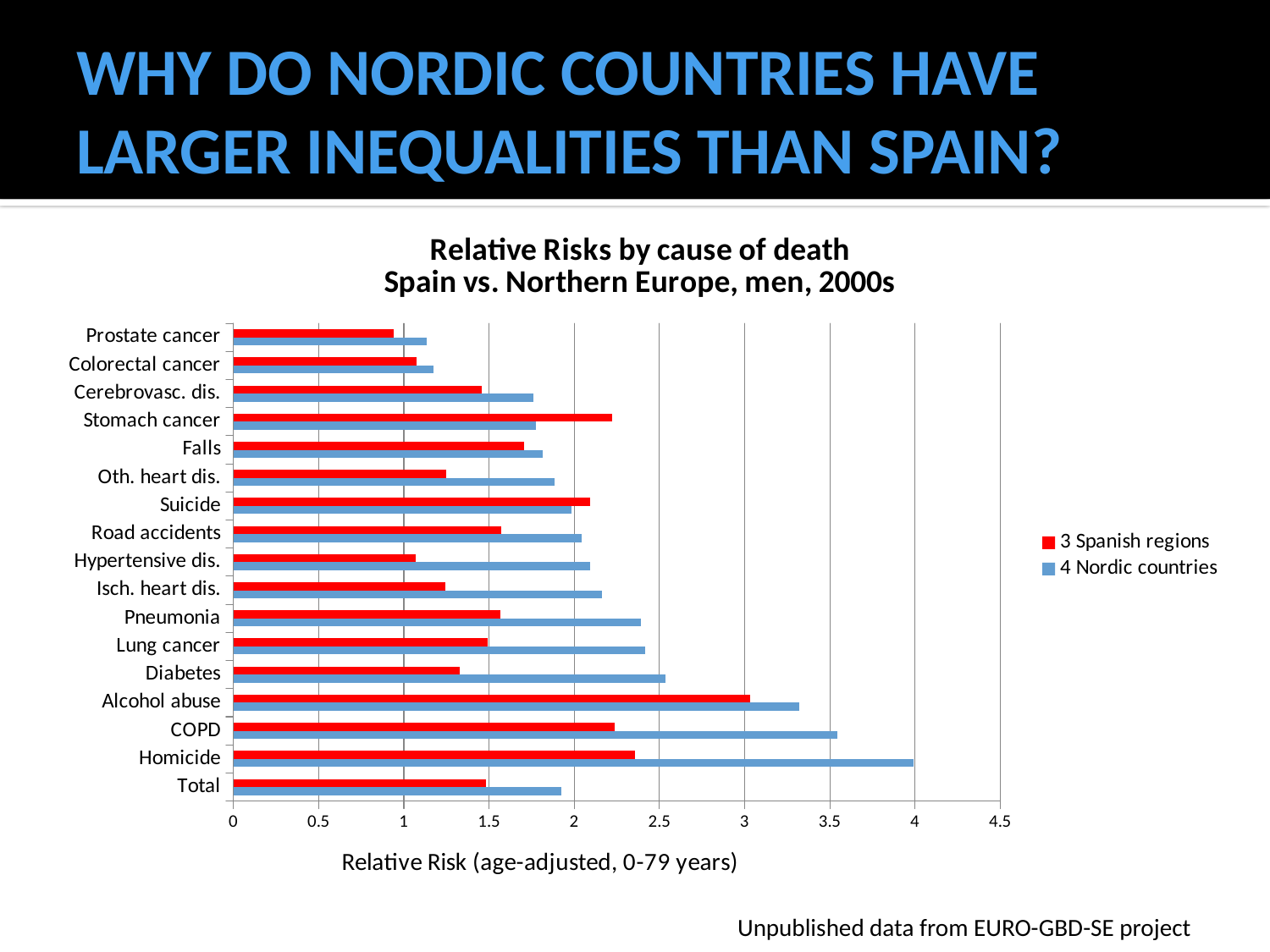
For Hypertensive dis., which series has the larger value: 3 Spanish regions or 4 Nordic countries? 4 Nordic countries Is the value for Homicide in the 4 Nordic countries series greater or less than 3.5? greater Is the value for Stomach cancer in the 3 Spanish regions series greater or less than 2? greater For Stomach cancer, which series has the larger value: 3 Spanish regions or 4 Nordic countries? 3 Spanish regions Which category has the lowest value for the 3 Spanish regions series? Prostate cancer Which category has the highest value for the 4 Nordic countries series? Homicide How many series does the legend list? 2 Is the value for Pneumonia in the 4 Nordic countries series greater or less than 2.5? less Which category has the highest value for the 3 Spanish regions series? Alcohol abuse How many causes of death (categories) are plotted on the chart? 17 What kind of chart is shown on the slide? bar chart